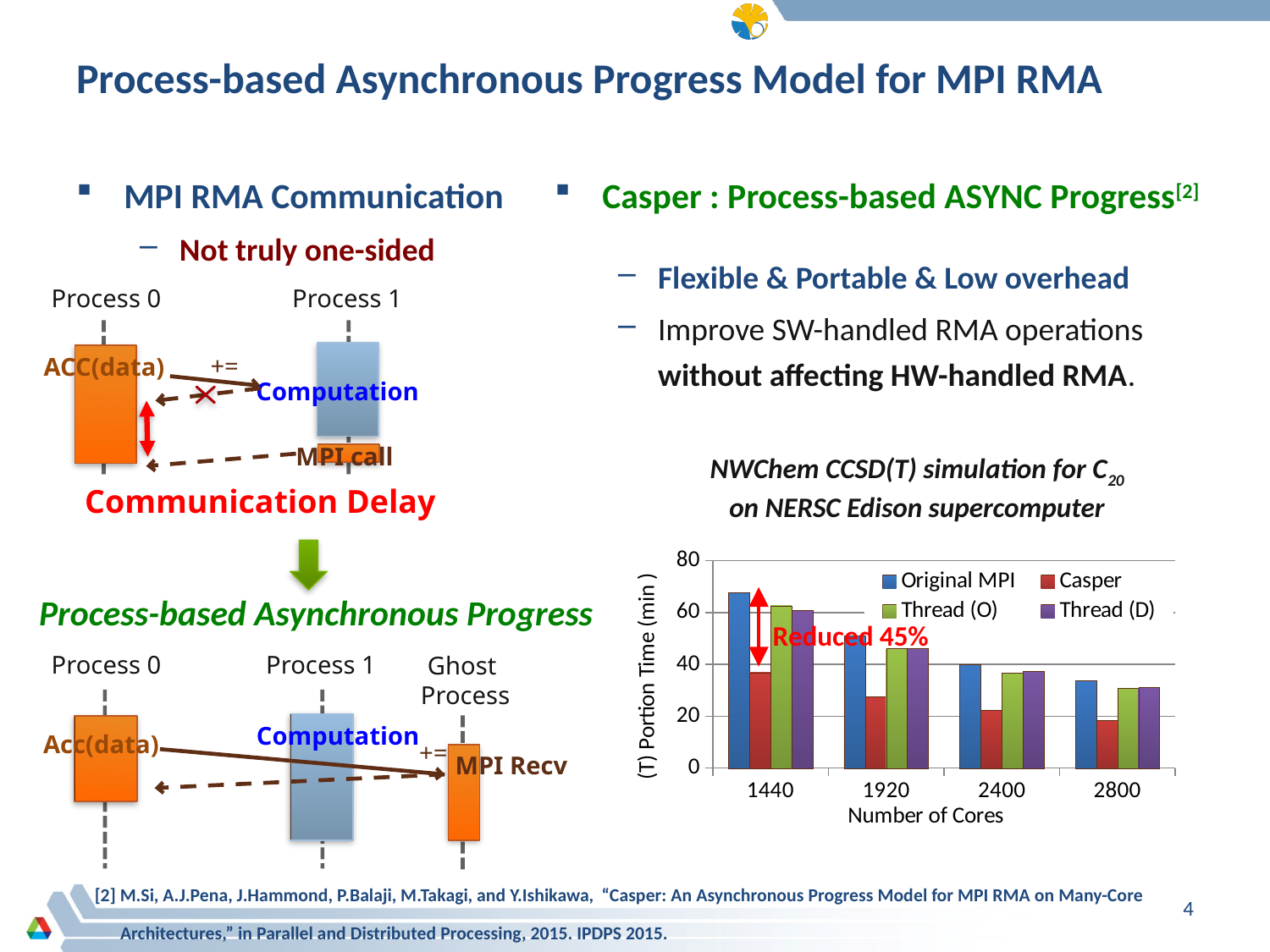
Is the Original MPI value at 2800 cores greater or less than 40? less How many series does the chart legend list? 4 Which series has the lowest value at 1440 cores? Casper Which series has the highest value at 1440 cores? Original MPI At 2400 cores, which is larger: the Original MPI value or the Casper value? Original MPI Does the Original MPI time rise or fall as the number of cores increases? fall Is the Casper value at 1920 cores greater or less than 40? less Is the Original MPI value at 1440 cores greater or less than 60? greater How many core-count categories are shown on the x axis of the chart? 4 What is the y-axis label of the chart? (T) Portion Time (min ) What is the x-axis title of the chart? Number of Cores What kind of chart is shown on the slide? bar chart